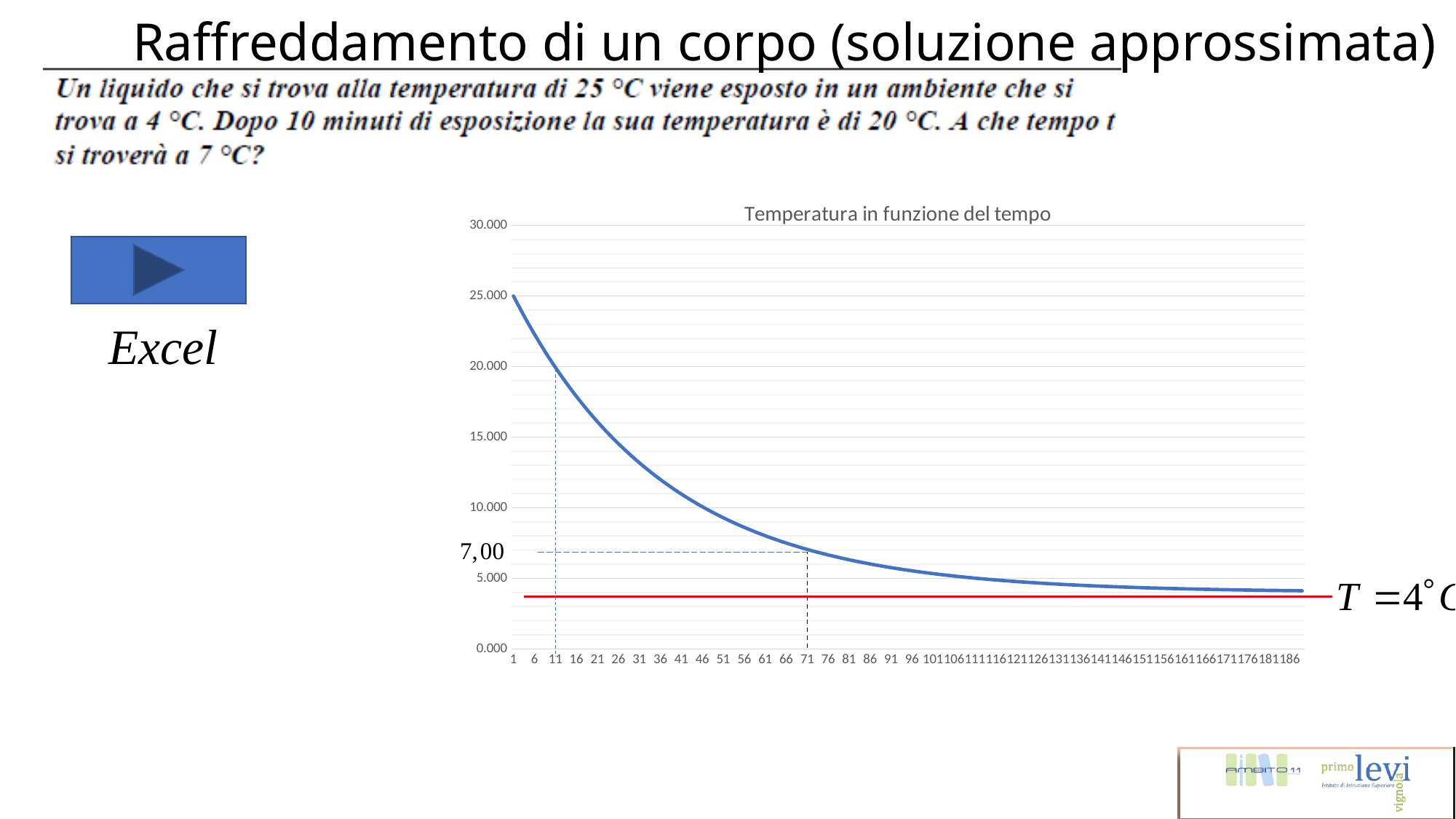
Do the values on the chart rise or fall as you move along the x axis? fall What is the title of the chart? Temperatura in funzione del tempo Is the value of the curve at x = 11 greater or less than 15.000? greater Is the value of the curve at x = 71 greater or less than 10.000? less Is the value of the curve at x = 41 greater or less than 5.000? greater What is the last x-axis label shown on the chart? 186 What is the value of the curve at x = 1? 25.000 What is the highest tick value shown on the y axis? 30.000 Which is larger, the value of the curve at x = 11 or at x = 71? x = 11 At which x value is the curve highest? 1 What kind of chart is shown on the slide? line chart